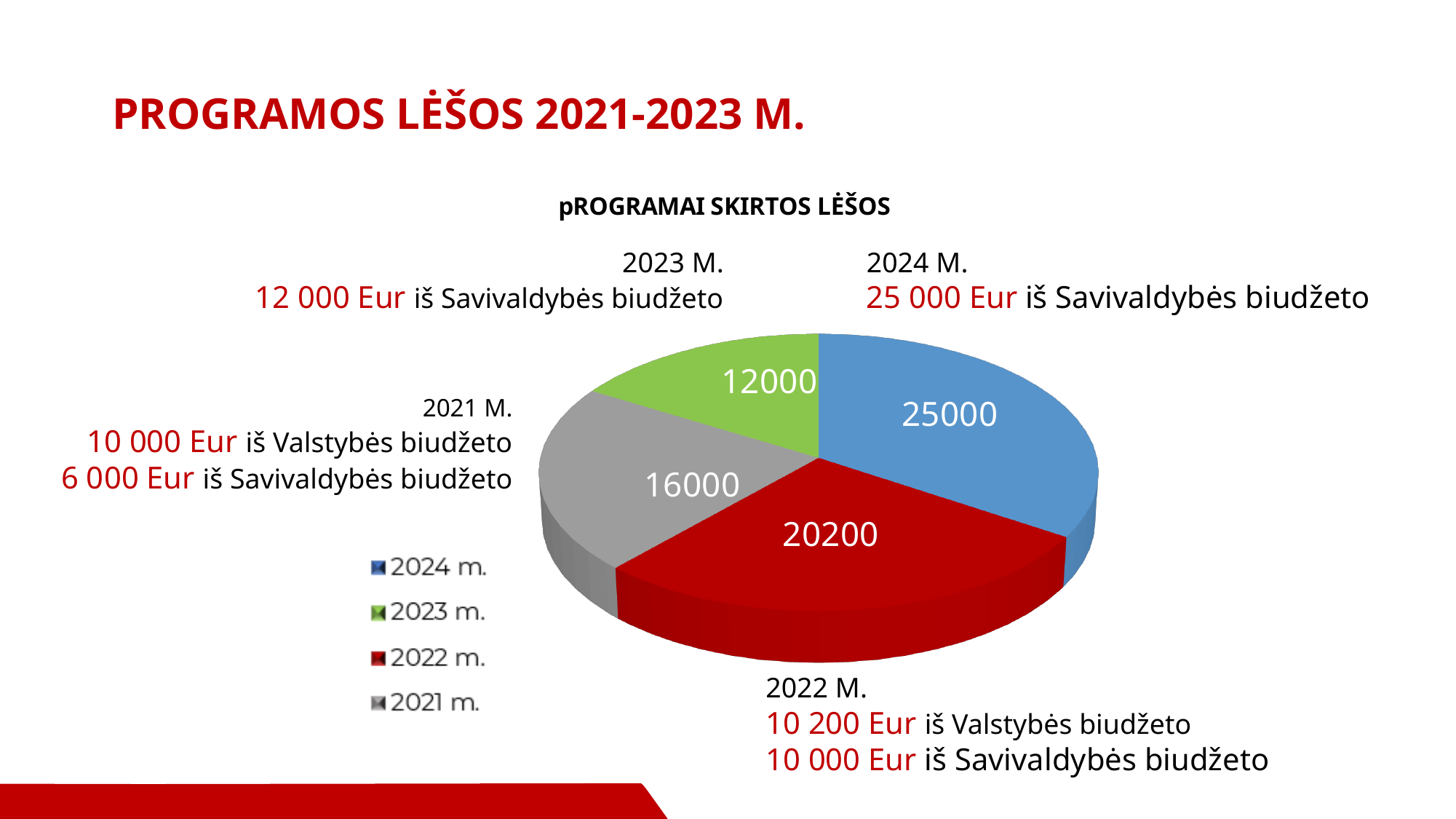
What value is shown for the 2023 m. slice? 12000 What is the title of the chart? pROGRAMAI SKIRTOS LĖŠOS How many slices does the pie chart have? 4 What colour is the 2022 m. slice in the pie chart? Red What value is shown for the 2022 m. slice? 20200 What value is shown for the 2024 m. slice? 25000 What value is shown for the 2021 m. slice? 16000 What is the difference between the 2024 m. value and the 2022 m. value? 4800 What type of chart is shown on the slide? Pie chart Which year has the largest slice in the pie chart? 2024 m. Which is larger, the value for 2021 m. or the value for 2023 m.? 2021 m. Which year has the smallest slice in the pie chart? 2023 m.